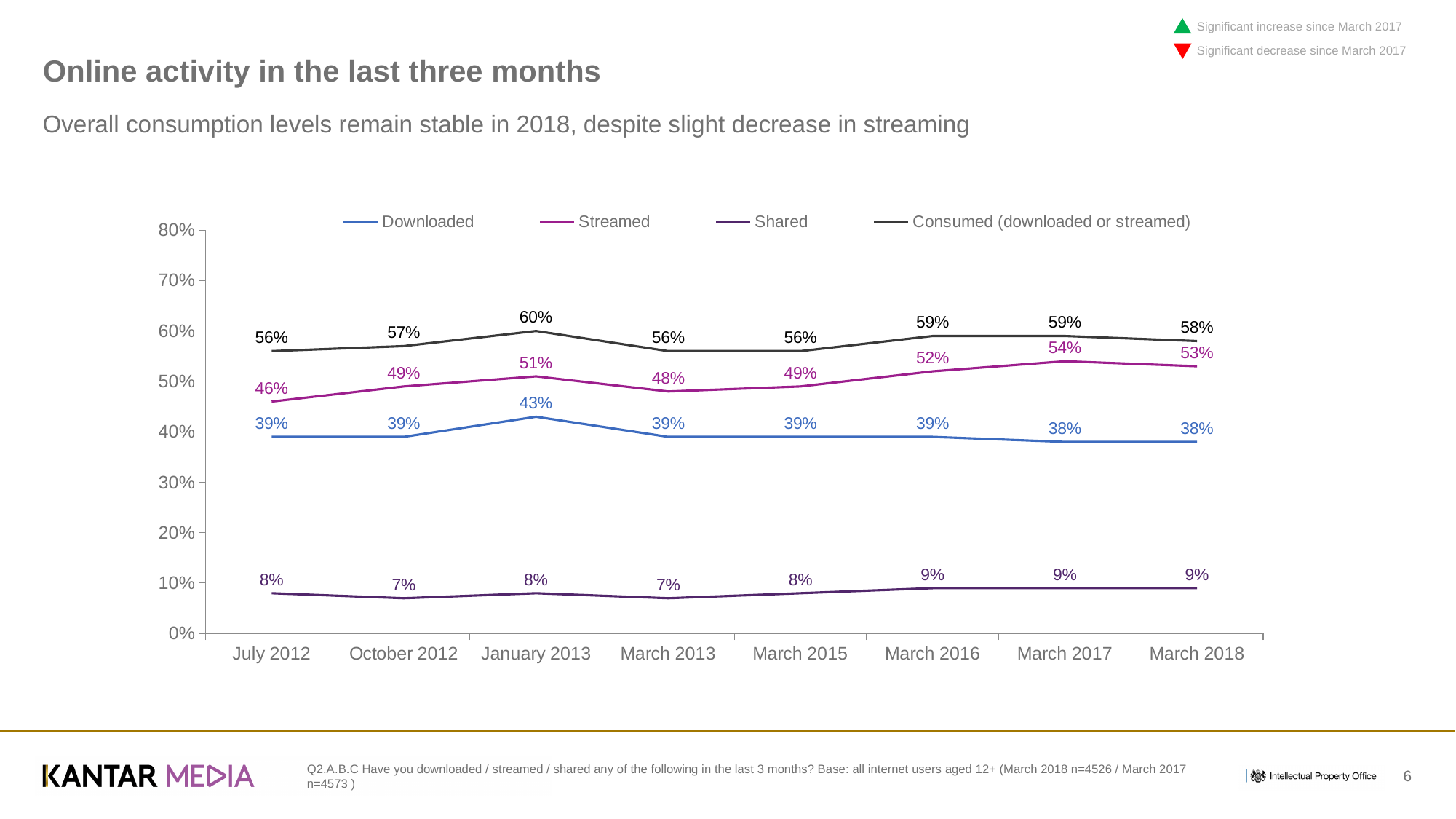
At which time point is the Streamed series lowest? July 2012 How many series does the legend list? 4 How many time points are shown on the x axis? 8 What is the title of the slide? Online activity in the last three months What is the value for Streamed in March 2018? 53% What is the difference between the Streamed values in March 2017 and March 2018? 1% At which time point is the Downloaded series highest? January 2013 Does the Shared series rise or fall from July 2012 to March 2018? rise What is the value for Shared in October 2012? 7% Which is larger in March 2016: the Streamed value or the Downloaded value? Streamed What is the value for Consumed (downloaded or streamed) in January 2013? 60% What kind of chart is shown on the slide? line chart